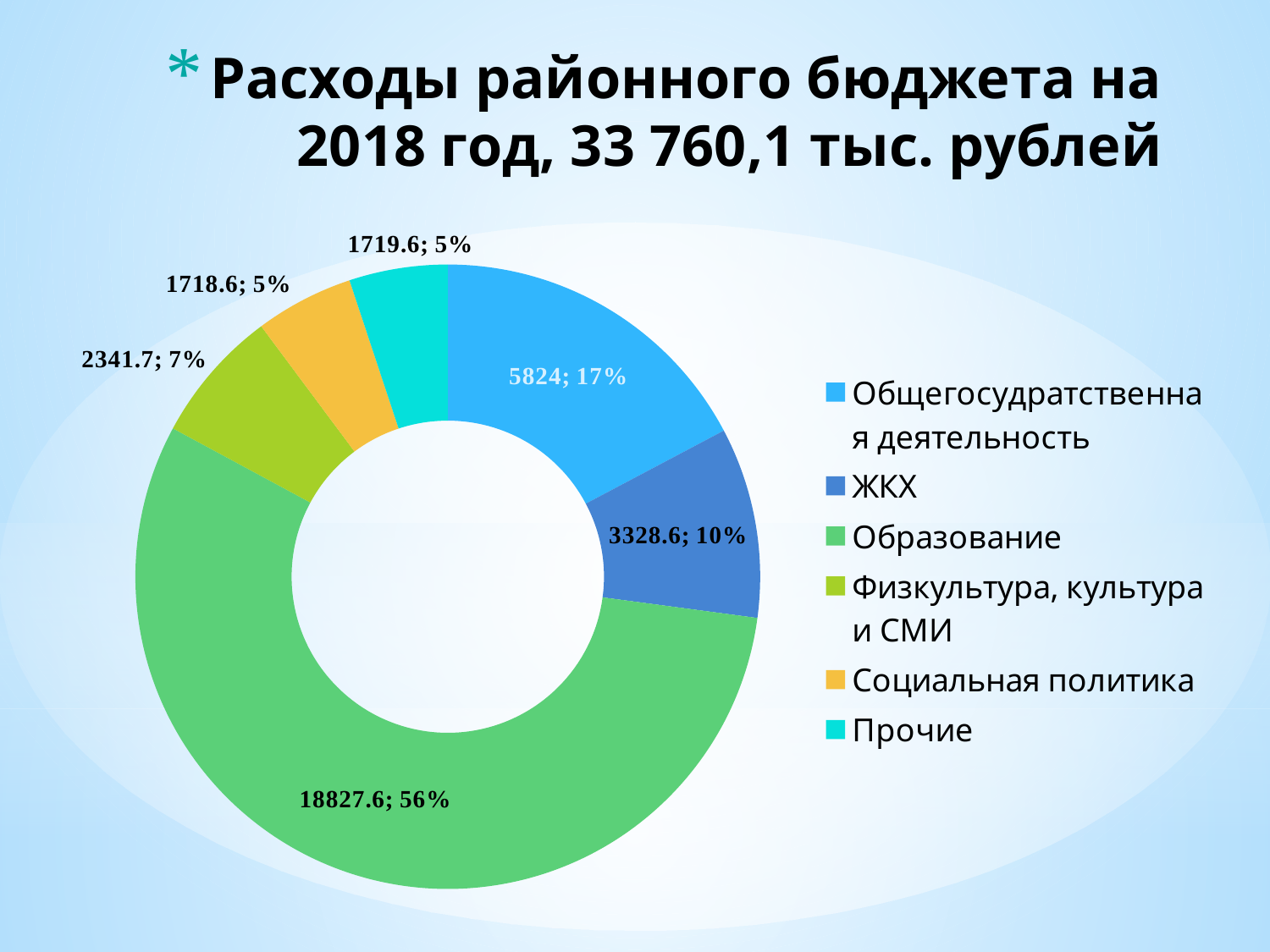
What value is shown for Социальная политика? 1718.6 What percentage share does Общегосударственная деятельность have? 17% Which is larger, the value for ЖКХ or the value for Физкультура, культура и СМИ? ЖКХ What percentage share does Физкультура, культура и СМИ have? 7% How many categories are shown in the chart? 6 What kind of chart is shown on the slide? Doughnut (pie) chart What value is shown for ЖКХ? 3328.6 What is the difference between the values for Образование and Общегосударственная деятельность? 13003.6 What value is shown for Образование? 18827.6 What percentage share does Образование have? 56% What value is shown for Прочие? 1719.6 Which category has the largest value? Образование